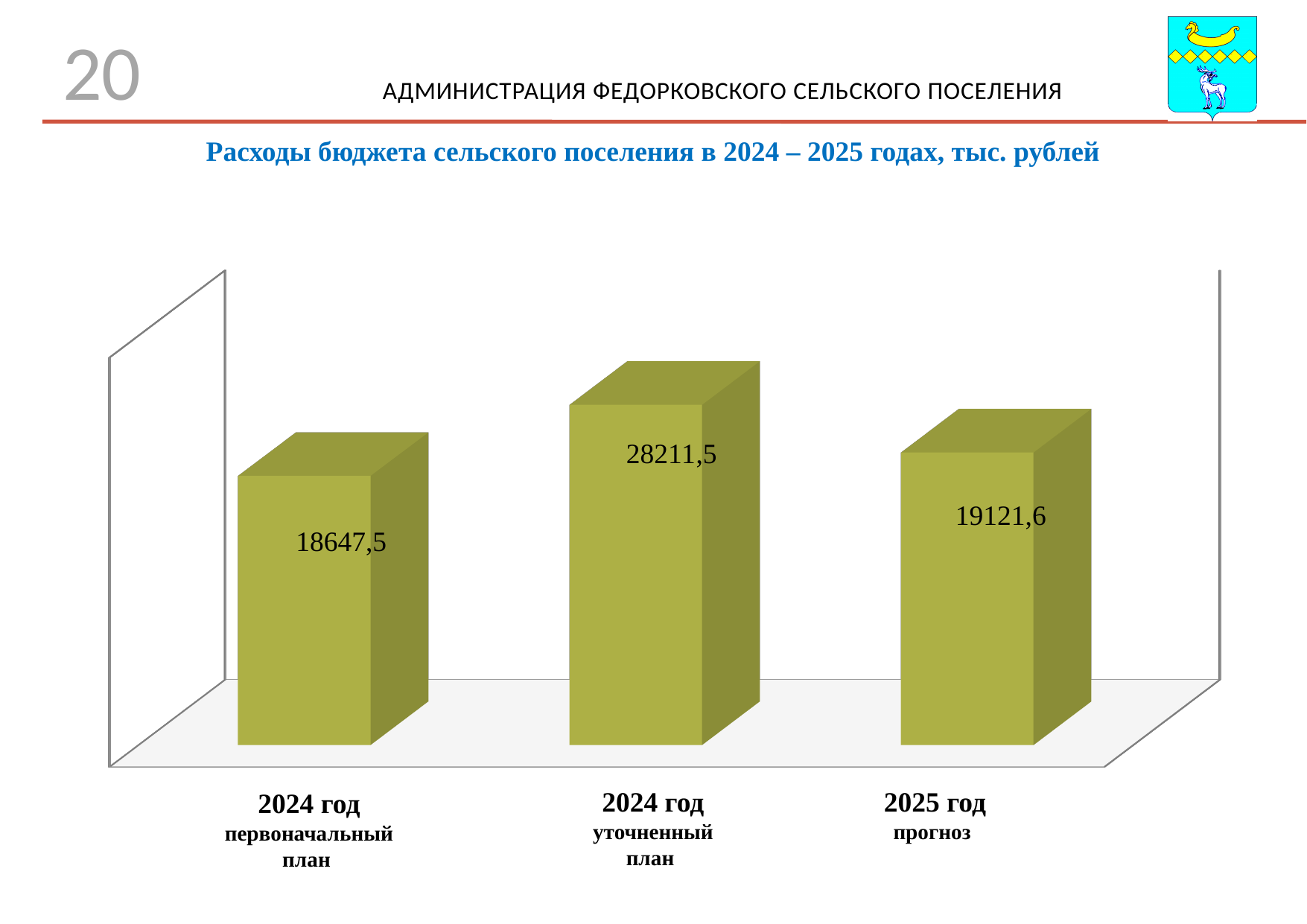
What is the value for 2025 год прогноз? 19121,6 Does the value rise or fall from 2024 год уточненный план to 2025 год прогноз? Falls What is the difference between the 2024 год уточненный план and the 2025 год прогноз values? 9089,9 Which is larger, the value for 2024 год уточненный план or the value for 2025 год прогноз? 2024 год уточненный план Which category has the lowest value? 2024 год первоначальный план What is the value for 2024 год первоначальный план? 18647,5 How many bars are shown in the chart? 3 Which category has the highest value? 2024 год уточненный план What is the title of the chart? Расходы бюджета сельского поселения в 2024 – 2025 годах, тыс. рублей What kind of chart is shown on the slide? Bar chart What is the difference between the 2024 год уточненный план and the 2024 год первоначальный план values? 9564,0 What is the value for 2024 год уточненный план? 28211,5